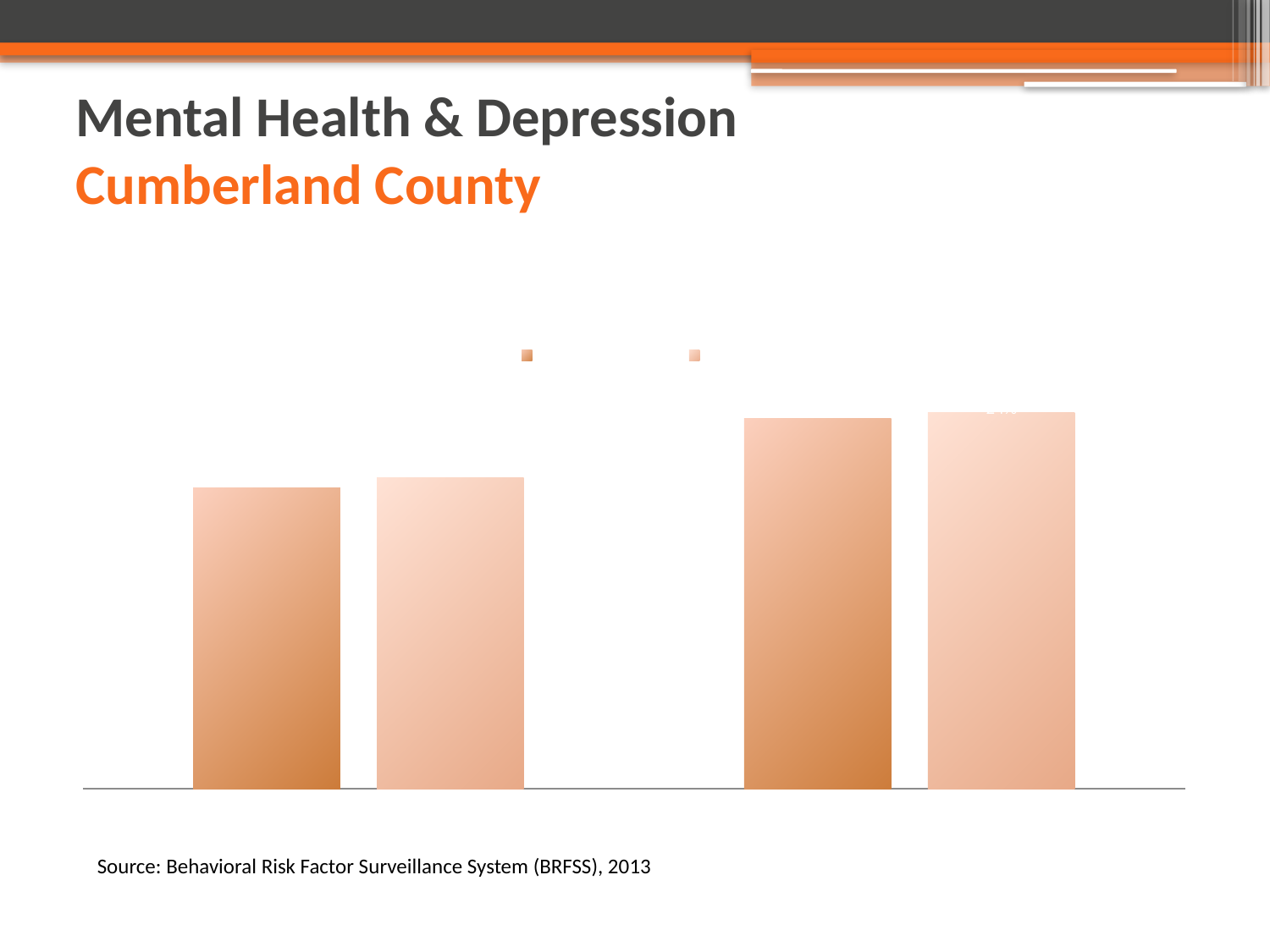
Into how many groups are the bars arranged along the x axis? 2 Is the second bar from the left or the third bar from the left taller? the third bar from the left What source is cited below the chart? Behavioral Risk Factor Surveillance System (BRFSS), 2013 What kind of chart is shown on the slide? bar chart How many bars are plotted in the chart? 4 Is the leftmost bar or the rightmost bar taller? the rightmost bar How many series does the chart's legend list? 2